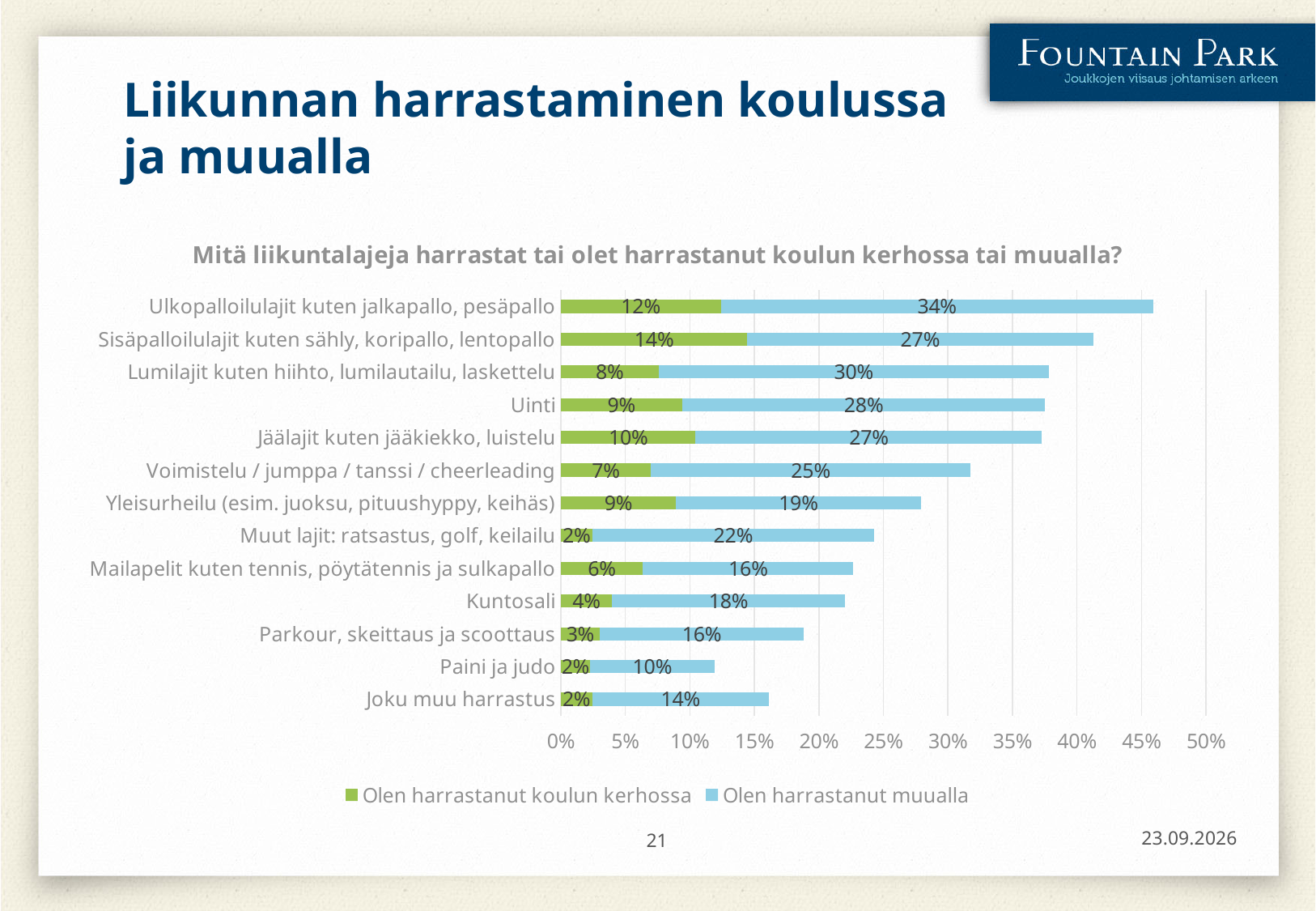
What is the difference between the 'Olen harrastanut muualla' values for Ulkopalloilulajit and Sisäpalloilulajit? 7% What is the total of the stacked bar for Ulkopalloilulajit kuten jalkapallo, pesäpallo? 46% How many sport categories are plotted in the chart? 13 What is the value of 'Olen harrastanut muualla' for Uinti? 28% What is the title of the chart? Mitä liikuntalajeja harrastat tai olet harrastanut koulun kerhossa tai muualla? What is the value of 'Olen harrastanut koulun kerhossa' for Lumilajit kuten hiihto, lumilautailu, laskettelu? 8% What is the total of the stacked bar for Voimistelu / jumppa / tanssi / cheerleading? 32% How many series does the legend list? 2 Which category has the lowest value for 'Olen harrastanut muualla'? Paini ja judo What kind of chart is shown on the slide? Stacked bar chart Which category has the highest value for 'Olen harrastanut koulun kerhossa'? Sisäpalloilulajit kuten sähly, koripallo, lentopallo Which is larger: the 'Olen harrastanut muualla' value for Kuntosali or for Mailapelit kuten tennis, pöytätennis ja sulkapallo? Kuntosali